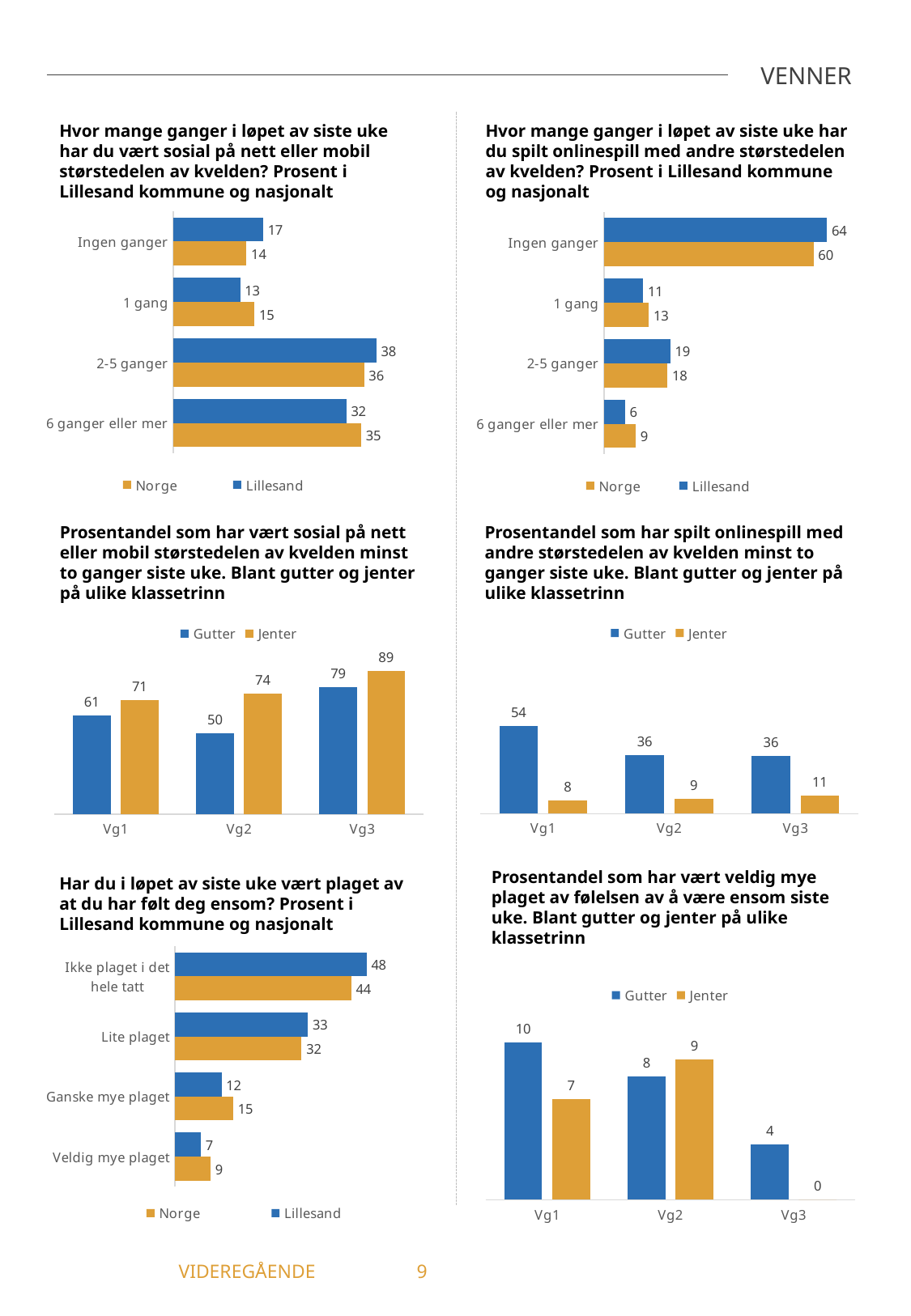
In the bottom-right chart (veldig mye plaget av følelsen av å være ensom), how many series does the legend list? 2 In the bottom-right chart (veldig mye plaget av følelsen av å være ensom), what is the value for Jenter at Vg3? 0 In the bottom-left chart (plaget av at du har følt deg ensom), what is the Norge value for 'Ganske mye plaget'? 15 In the middle-left chart (sosial på nett minst to ganger, gutter og jenter), what is the value for Jenter at Vg3? 89 In the middle-left chart (sosial på nett minst to ganger), which group has the lowest value across all bars? Gutter at Vg2 In the top-right chart (spilt onlinespill), how many categories are shown? 4 In the middle-right chart (spilt onlinespill minst to ganger, gutter og jenter), which is larger at Vg1: Gutter or Jenter? Gutter In the middle-right chart (spilt onlinespill minst to ganger), what is the difference between Gutter and Jenter at Vg1? 46 In the top-left chart (sosial på nett eller mobil, Lillesand kommune og nasjonalt), what is the Lillesand value for '2-5 ganger'? 38 In the top-left chart (sosial på nett eller mobil), what is the Norge value for '6 ganger eller mer'? 35 In the top-right chart (spilt onlinespill), what is the difference between the Lillesand and Norge values for 'Ingen ganger'? 4 In the top-right chart (spilt onlinespill, Lillesand kommune og nasjonalt), which category has the highest Lillesand value? Ingen ganger